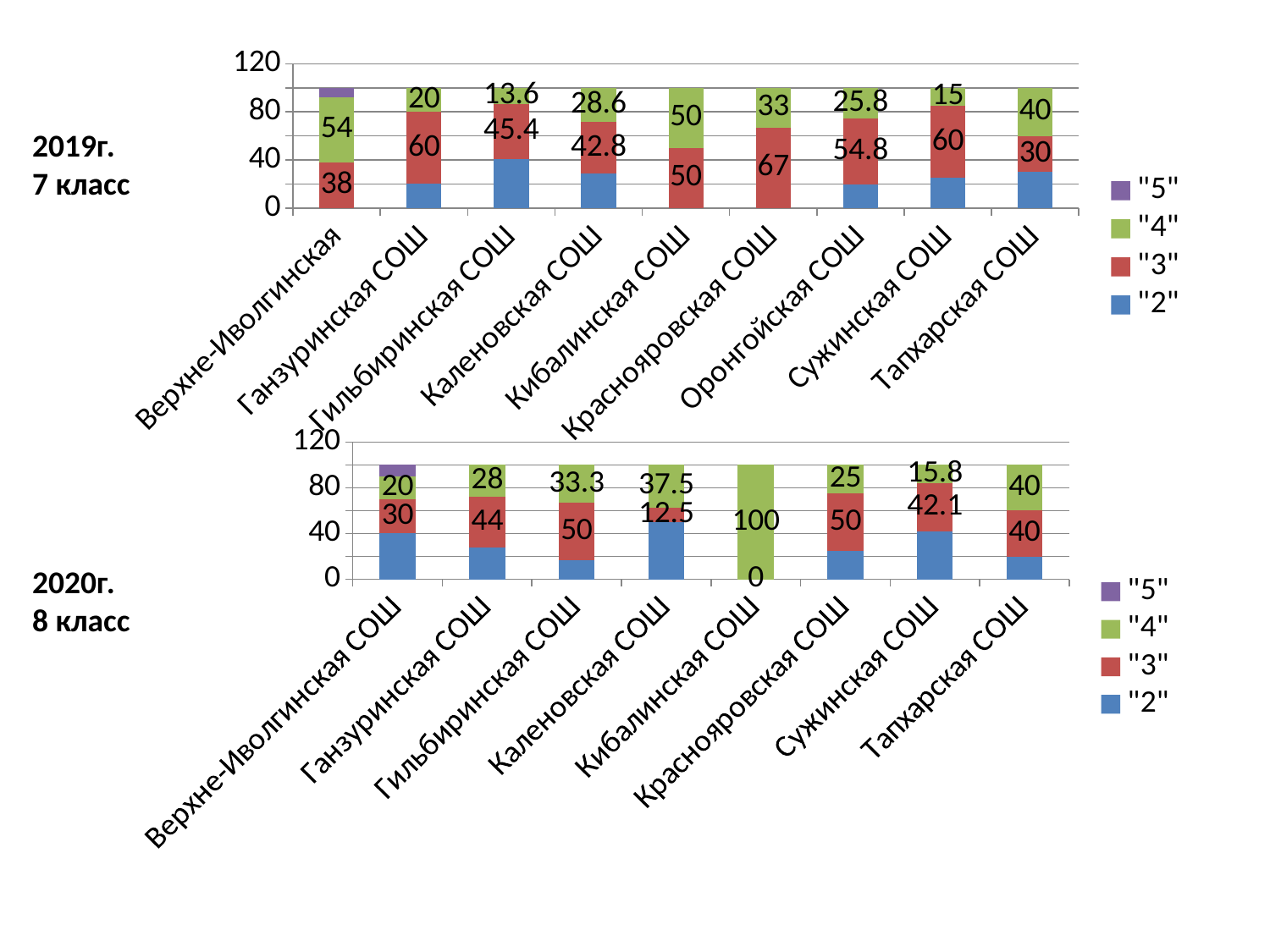
In the 2019г. 7 класс chart, what is the value of the "3" series for Краснояровская СОШ? 67 In the 2019г. 7 класс chart, which school has the lowest labelled value for the "4" series? Гильбиринская СОШ How many series does the legend of the 2020г. 8 класс chart list? 4 What type of chart is the 2019г. 7 класс chart? Stacked bar chart In the 2019г. 7 класс chart, what is the value of the "4" series for Оронгойская СОШ? 25.8 In the 2020г. 8 класс chart, what is the value of the "4" series for Кибалинская СОШ? 100 In the 2019г. 7 класс chart, which is larger for Тапхарская СОШ: the "4" value or the "3" value? "4" How many schools are shown on the x axis of the 2019г. 7 класс chart? 9 In the 2019г. 7 класс chart, which school has the highest value for the "3" series? Краснояровская СОШ In the 2020г. 8 класс chart, is the "2" value for Каленовская СОШ greater or less than 40? greater In the 2020г. 8 класс chart, what is the value of the "3" series for Сужинская СОШ? 42.1 In the 2020г. 8 класс chart, what is the difference between the "3" value and the "4" value for Гильбиринская СОШ? 16.7